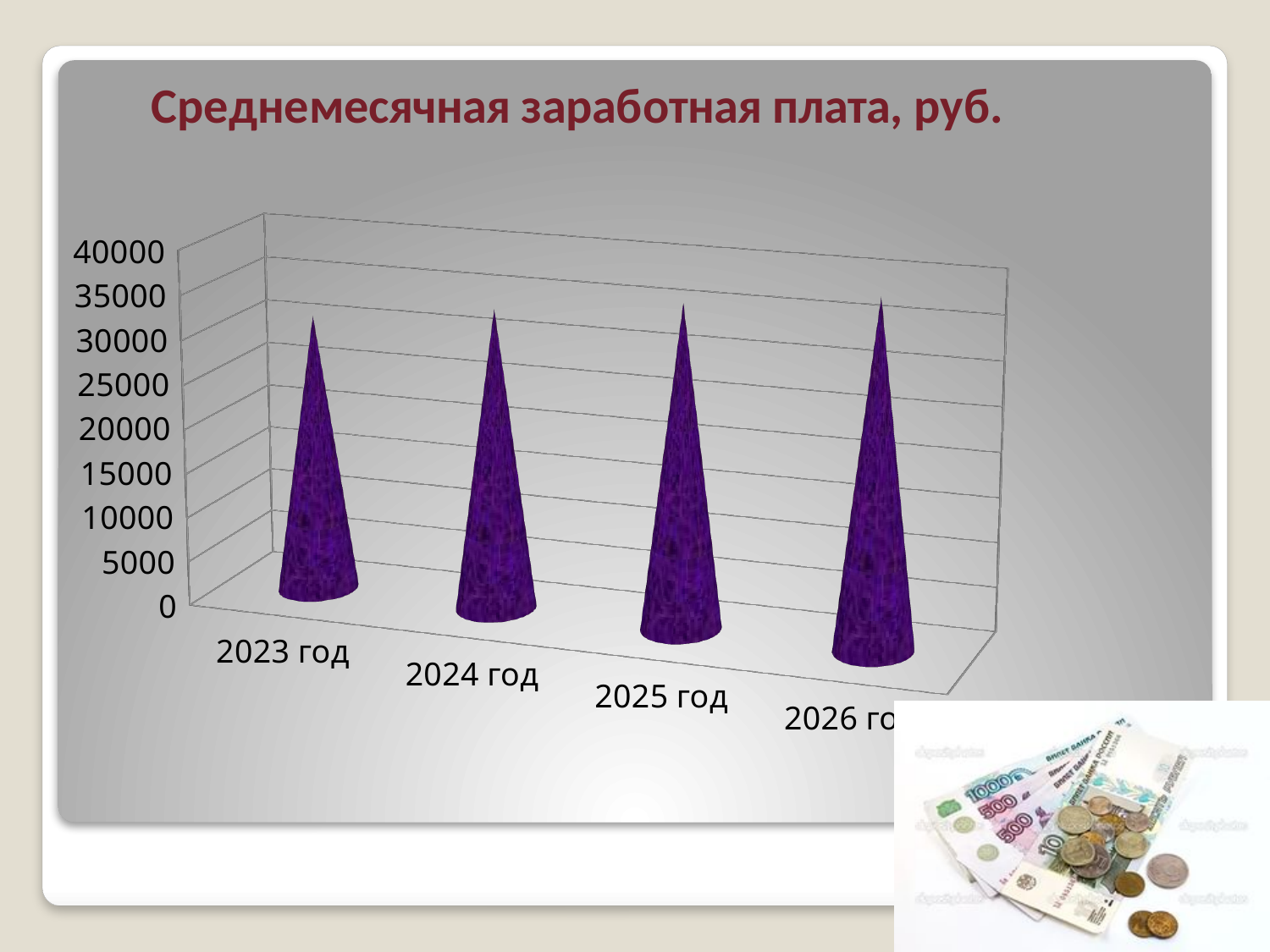
What kind of chart is shown on the slide? bar chart How many years (categories) are shown on the chart? 4 Is the value for 2026 год greater or less than 40000? less What is the maximum value shown on the vertical axis? 40000 Which is larger, the value for 2023 год or the value for 2026 год? 2026 год Do the values rise or fall from 2023 to 2026? rise Which year has the lowest average monthly salary on the chart? 2023 год Which year has the highest average monthly salary on the chart? 2026 год What is the title of the chart? Среднемесячная заработная плата, руб. Is the value for 2024 год greater or less than 15000? greater Is the value for 2023 год greater or less than 20000? greater